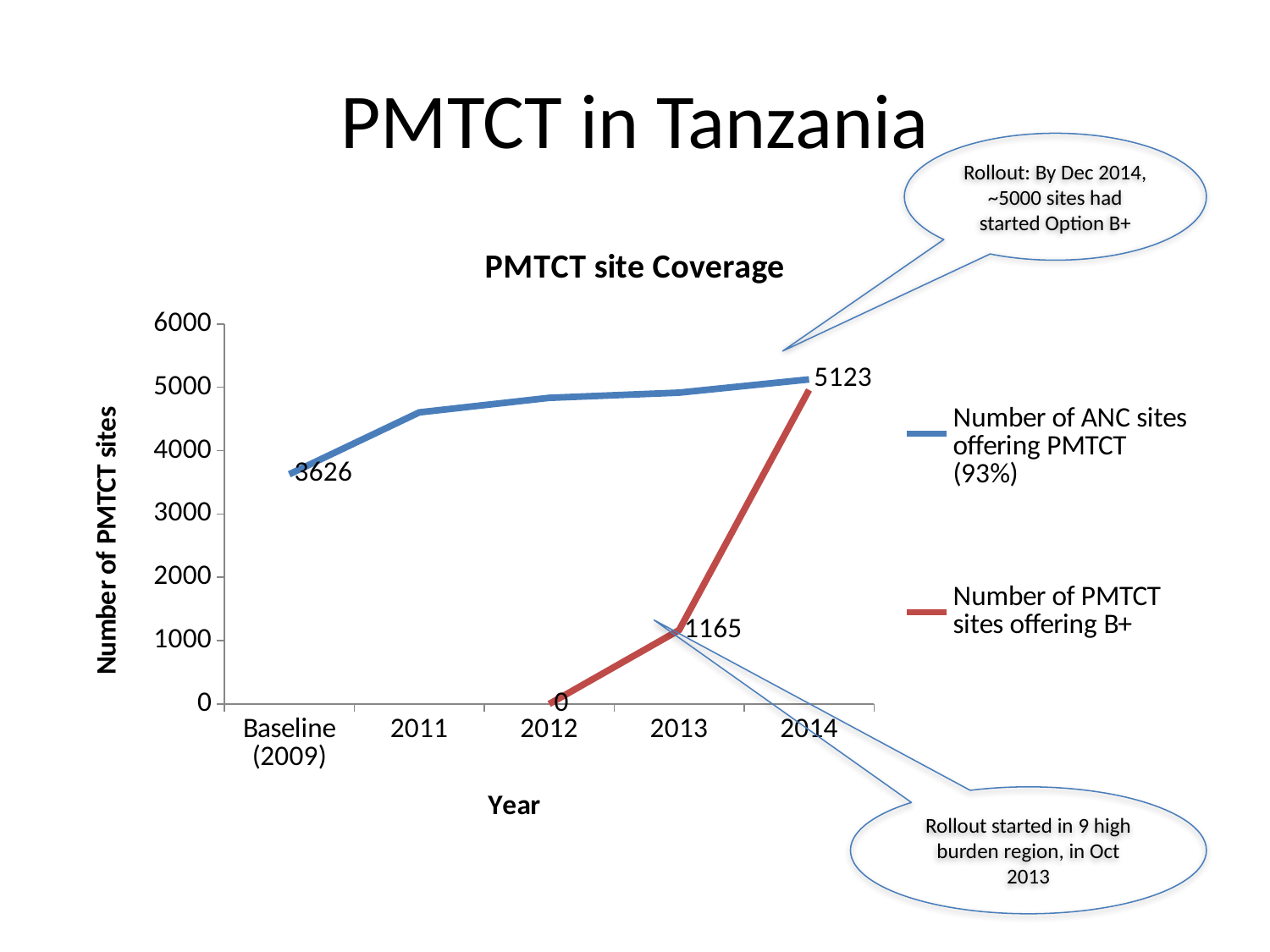
Is the number of PMTCT sites offering B+ in 2014 greater or less than 4000? greater What is the title of the chart? PMTCT site Coverage How many series does the chart legend list? 2 In 2013, which series has the higher value: Number of ANC sites offering PMTCT or Number of PMTCT sites offering B+? Number of ANC sites offering PMTCT What is the number of ANC sites offering PMTCT at Baseline (2009)? 3626 What type of chart is shown on the slide? Line chart Does the number of PMTCT sites offering B+ rise or fall from 2012 to 2014? Rise What is the highest data label printed on the chart? 5123 How many categories are shown on the x axis of the chart? 5 What is the number of PMTCT sites offering B+ in 2012? 0 What is the number of PMTCT sites offering B+ in 2013? 1165 Is the number of ANC sites offering PMTCT in 2011 greater or less than 4000? greater